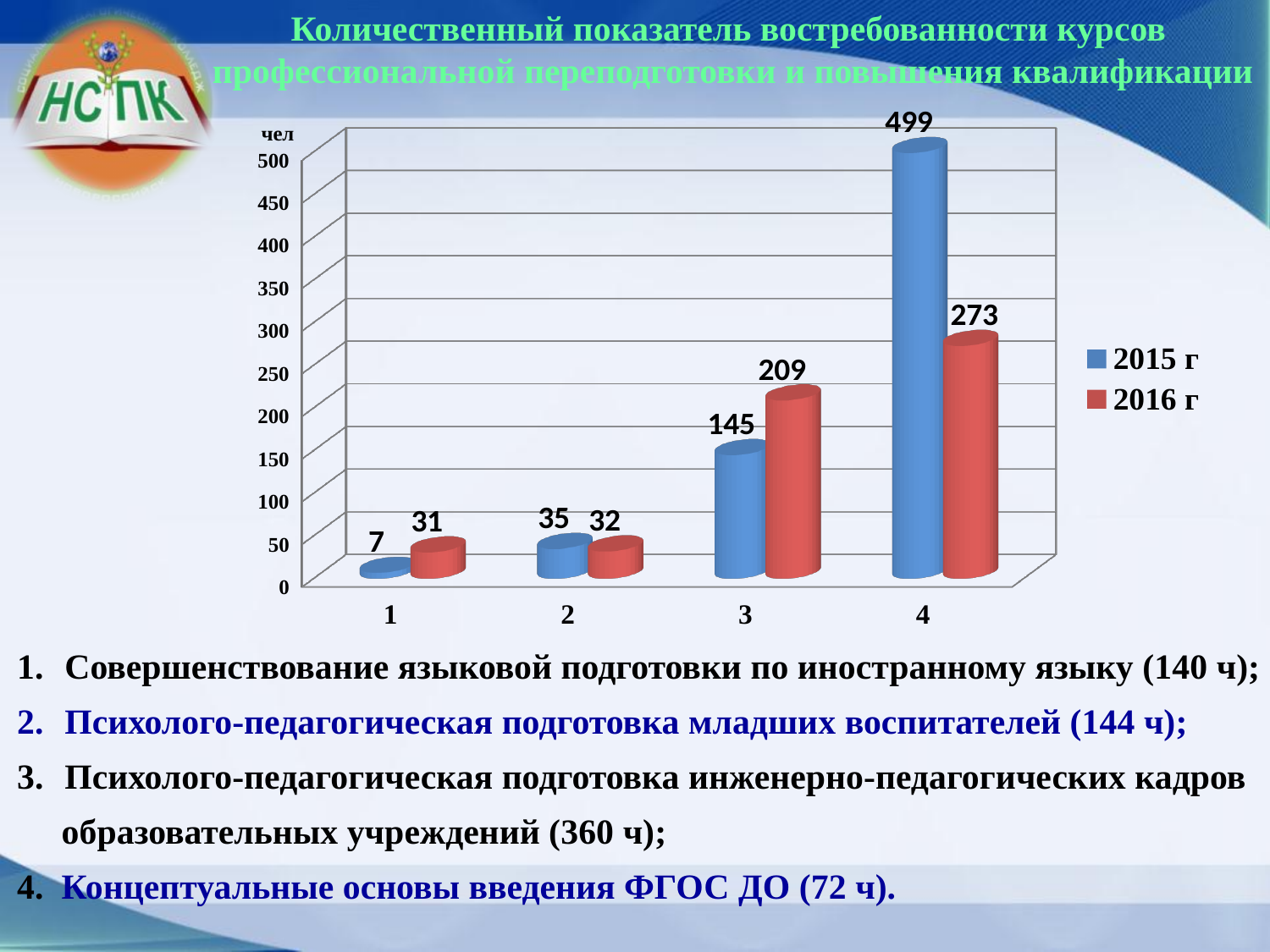
Which category has the highest value in the 2015 г series? 4 Which is larger for category 3: the 2015 г value or the 2016 г value? 2016 г What is the value for category 4 in the 2015 г series? 499 What unit label is shown at the top of the vertical axis? чел Which category has the lowest value in the 2015 г series? 1 What is the difference between the 2015 г and 2016 г values for category 4? 226 How many categories are shown on the x axis? 4 What is the value for category 1 in the 2016 г series? 31 What kind of chart is shown on the slide? bar chart How many series does the legend list? 2 What is the value for category 3 in the 2016 г series? 209 Do the 2016 г values rise or fall from category 1 to category 4? rise